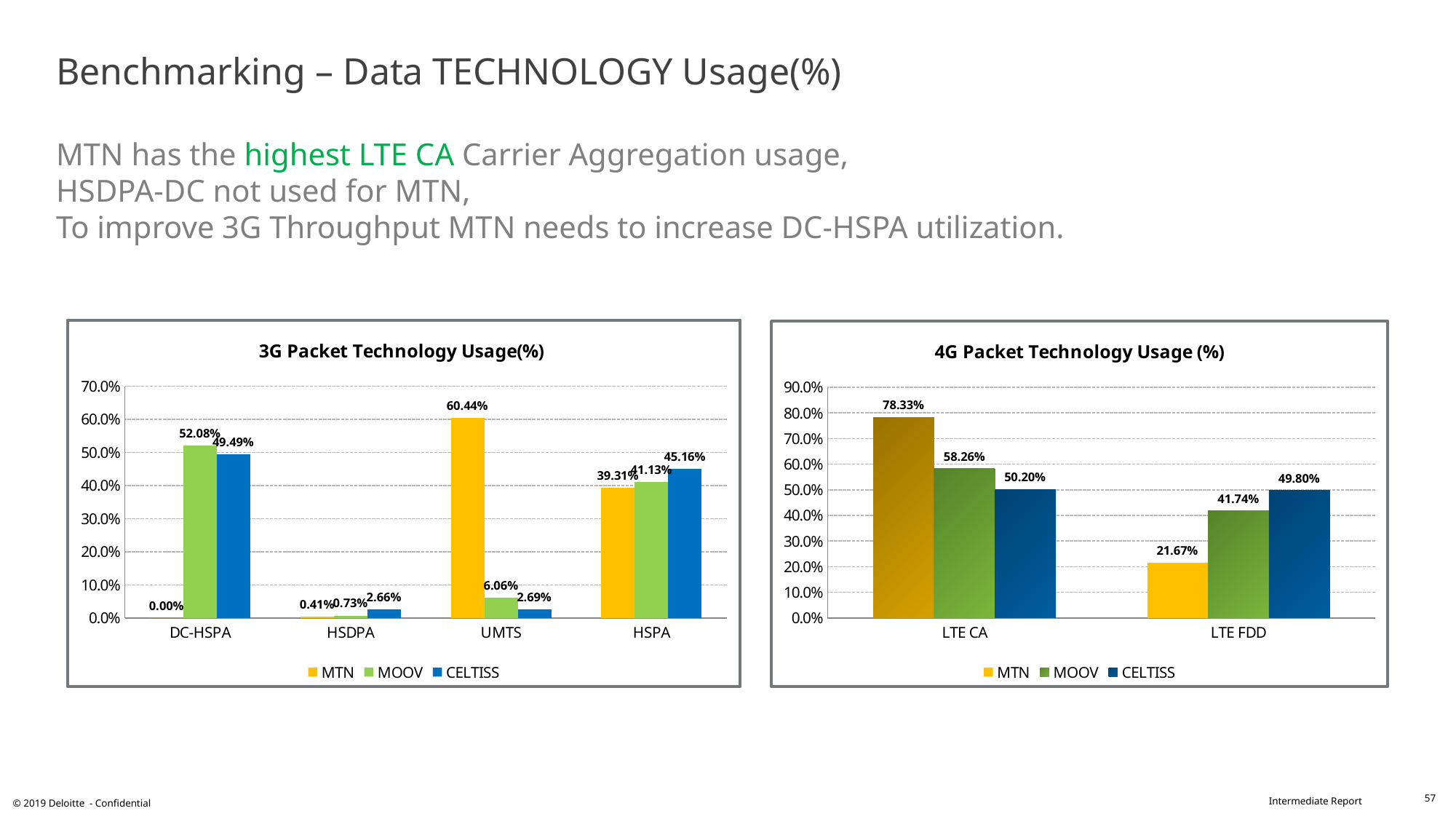
In the 4G Packet Technology Usage (%) chart, what is the difference between the MTN and CELTISS values in the LTE CA category? 28.13% What type of chart is the 4G Packet Technology Usage (%) chart? Bar chart In the 3G Packet Technology Usage(%) chart, what is the value for CELTISS in the HSPA category? 45.16% In the 4G Packet Technology Usage (%) chart, how many series does the legend list? 3 In the 3G Packet Technology Usage(%) chart, what is the value for MOOV in the DC-HSPA category? 52.08% In the 3G Packet Technology Usage(%) chart, how many technology categories are shown on the x axis? 4 In the 4G Packet Technology Usage (%) chart, what is the value for CELTISS in the LTE FDD category? 49.80% In the 3G Packet Technology Usage(%) chart, which operator has the lowest value in the DC-HSPA category? MTN In the 4G Packet Technology Usage (%) chart, what is the value for MTN in the LTE CA category? 78.33% In the 3G Packet Technology Usage(%) chart, what is the difference between the MTN and MOOV values in the UMTS category? 54.38% In the 3G Packet Technology Usage(%) chart, what is the value for MTN in the UMTS category? 60.44% In the 4G Packet Technology Usage (%) chart, which operator has the highest value in the LTE FDD category? CELTISS